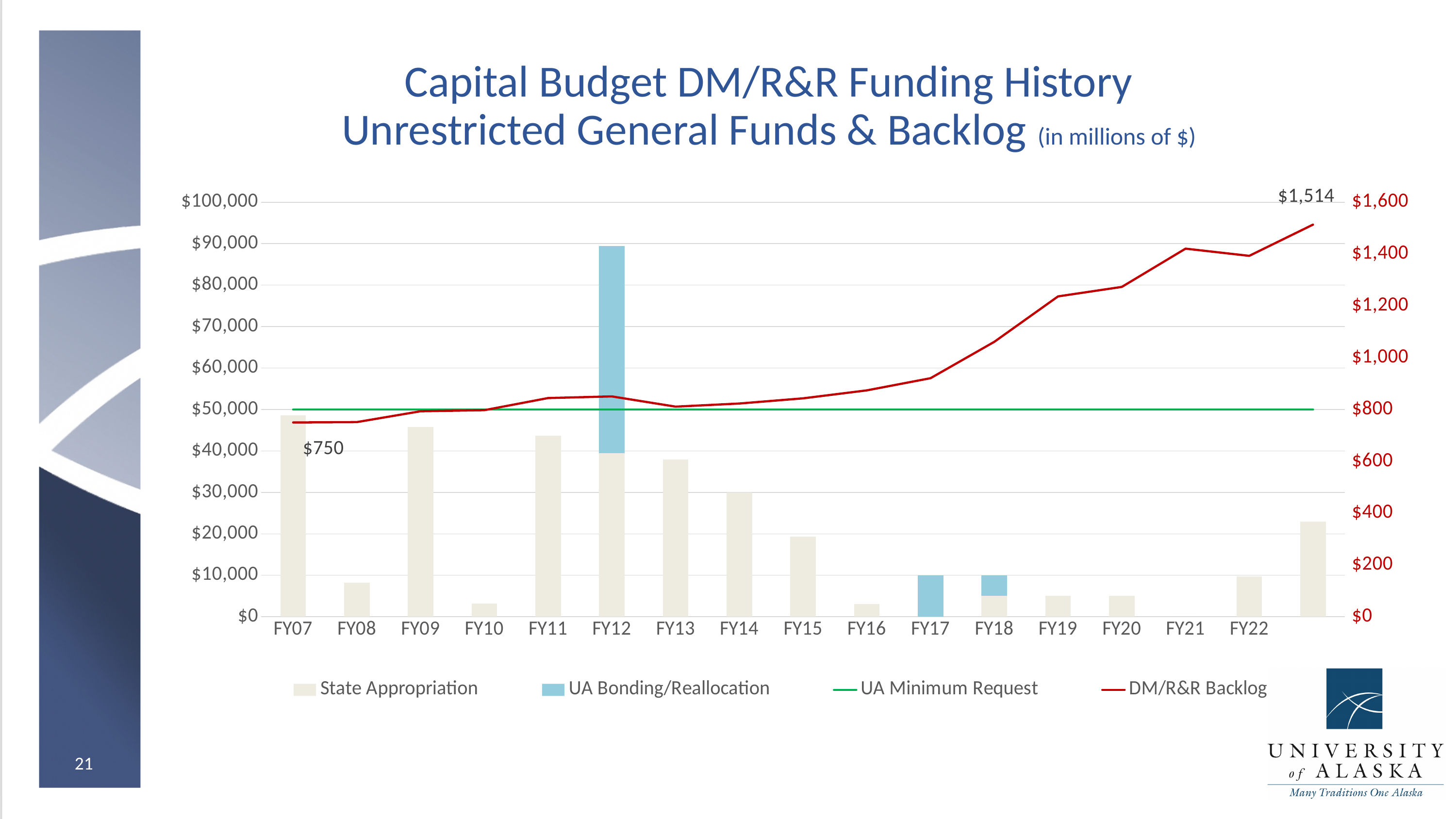
What is the highest DM/R&R Backlog value labeled on the chart? $1,514 Which is larger, the State Appropriation for FY13 or for FY15? FY13 What kind of chart is shown on the slide? bar and line chart How many fiscal years are labeled on the x axis? 16 What colour represents UA Bonding/Reallocation in the legend? blue What is the DM/R&R Backlog value labeled at FY07? $750 How many series does the legend list? 4 Which fiscal year has the largest UA Bonding/Reallocation bar? FY12 Is the State Appropriation for FY08 greater or less than $10,000? less Is the total height of the FY12 bar greater or less than $80,000 on the left axis? greater Does the DM/R&R Backlog line generally rise or fall from FY07 to the end of the chart? rise By how much does the labeled DM/R&R Backlog value of $1,514 exceed the FY07 labeled value of $750? $764